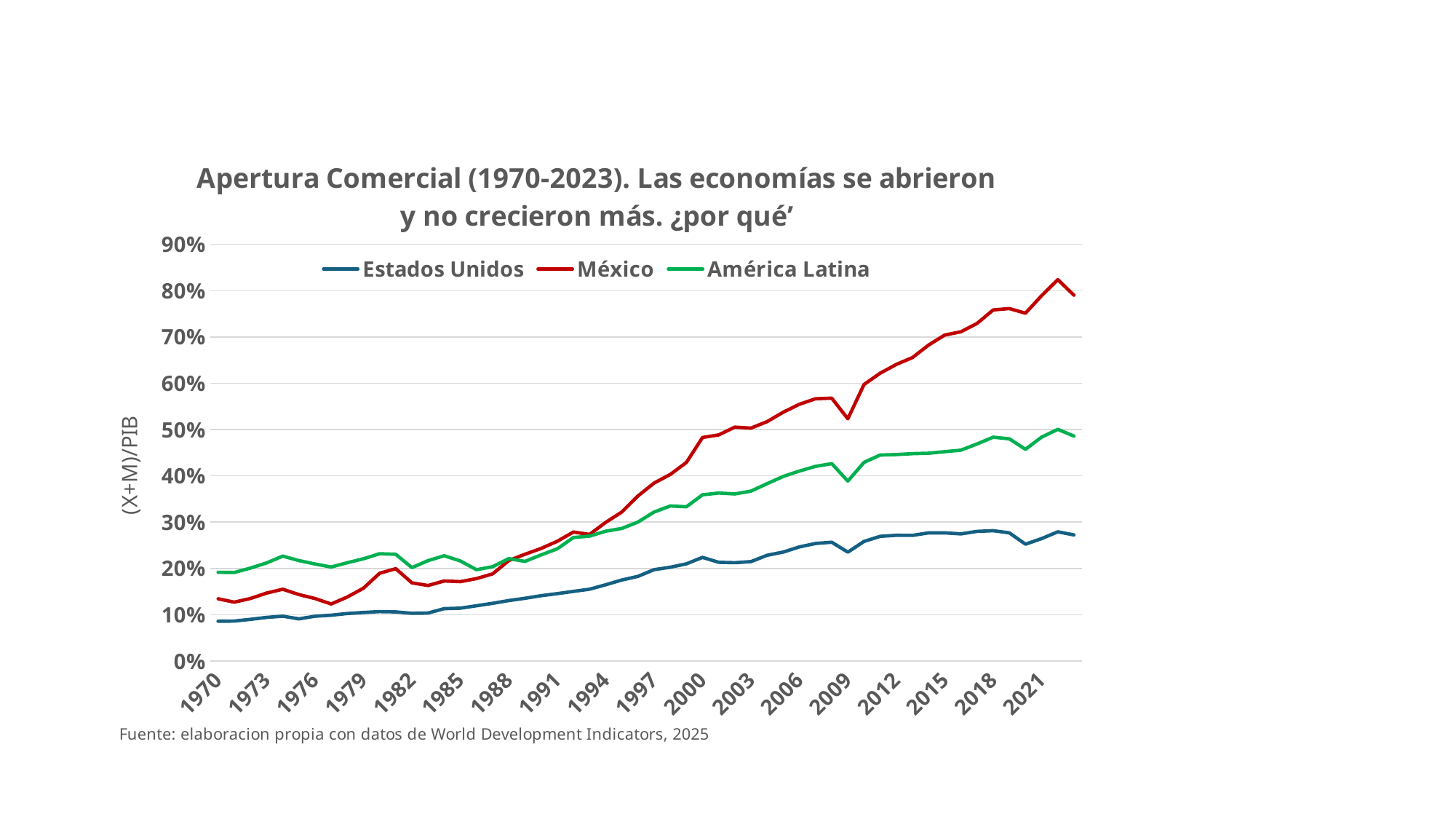
Which series does the legend list between Estados Unidos and América Latina? México Which series has the lowest value in 2021? Estados Unidos What kind of chart is shown on the slide? line chart Is the value for México in 2021 greater or less than 70%? greater In 1976, which is larger: the value for América Latina or the value for México? América Latina What is the label on the vertical axis? (X+M)/PIB Does the Estados Unidos series generally rise or fall from 1970 to 2023? rise Is the value for Estados Unidos in 2021 greater or less than 30%? less How many series does the legend list? 3 Is the value for América Latina in 2021 greater or less than 40%? greater Which series has the highest value in 2021? México